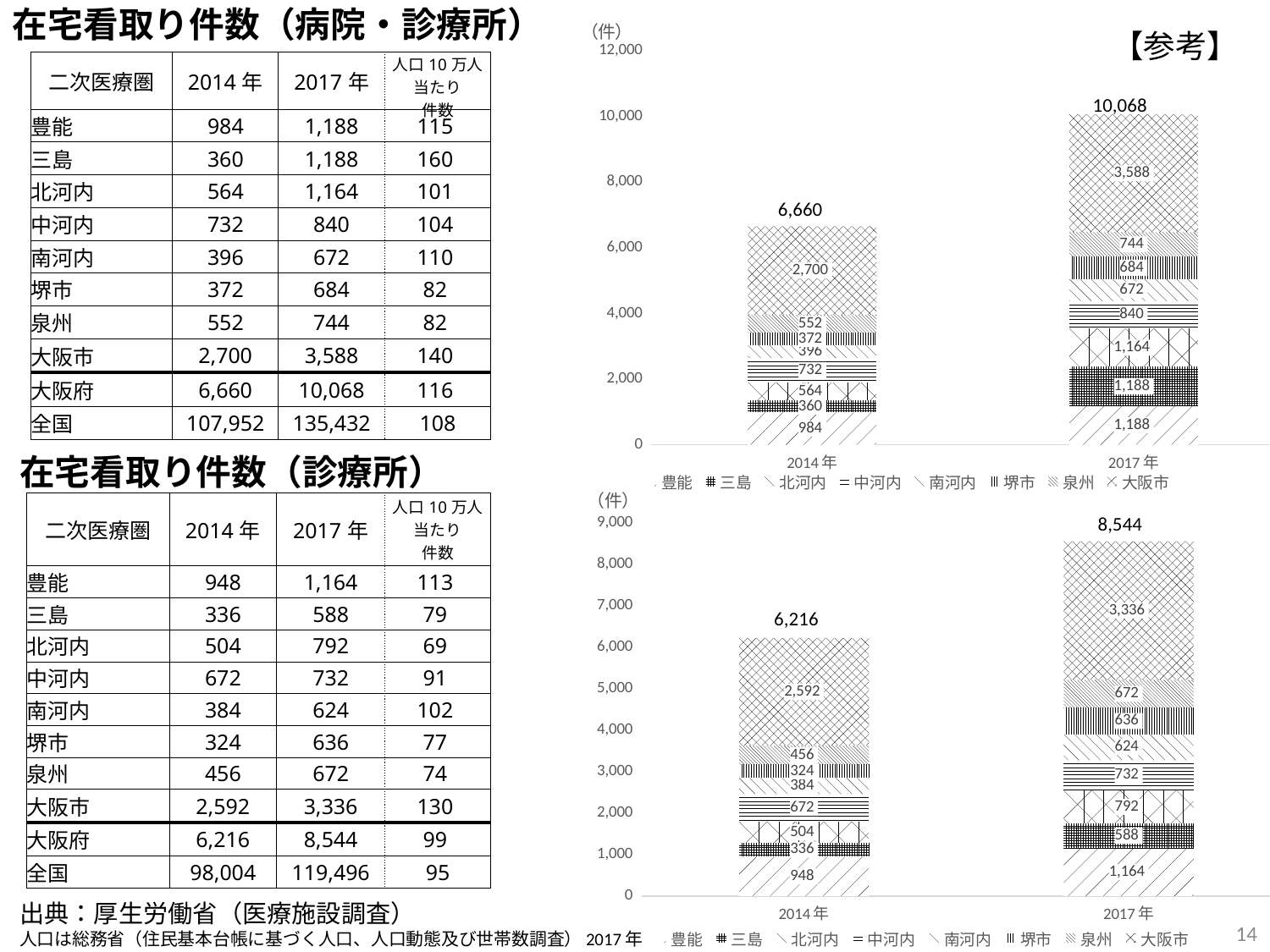
In the lower chart, which segment is the smallest in the 2014年 bar? 堺市 In the lower chart, does the total rise or fall from 2014年 to 2017年? Rise In the lower chart, is the 2017年 total greater or less than 8,000? greater In the upper chart, what is the value of the 大阪市 segment for 2014年? 2,700 How many series does the legend of the lower chart list? 8 In the upper chart, what is the value of the 中河内 segment for 2017年? 840 In the lower chart (在宅看取り件数（診療所）), what is the total for 2014年? 6,216 In the upper chart (在宅看取り件数（病院・診療所）), what is the total for 2017年? 10,068 What kind of chart is the upper chart? Stacked bar chart In the upper chart, which segment is the largest in the 2017年 bar? 大阪市 In the lower chart, what is the value of the 泉州 segment for 2017年? 672 In the upper chart, what is the difference between the 2017年 total and the 2014年 total? 3,408